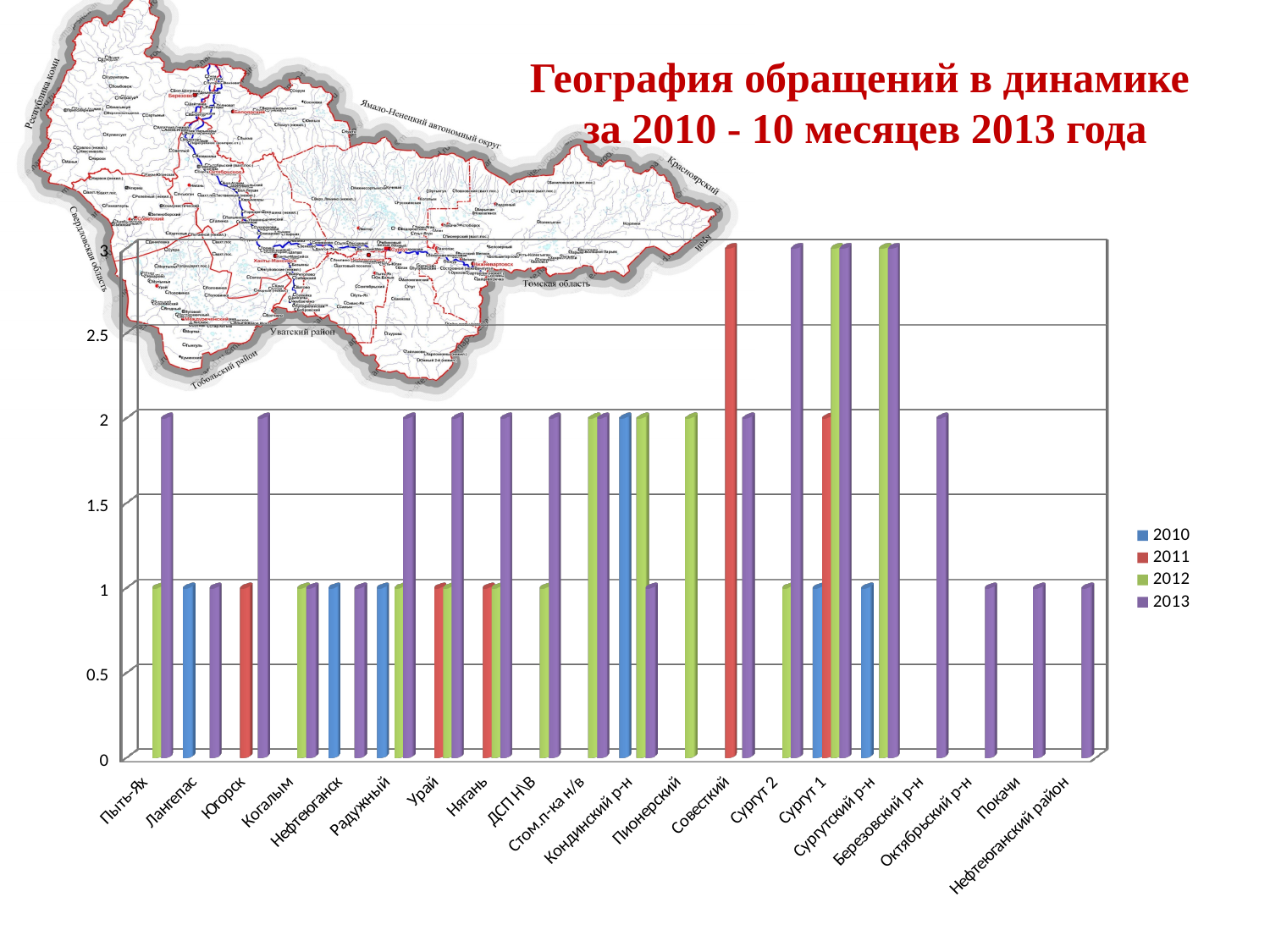
Which series is shown in purple in the legend? 2013 What is the value for Пионерский in 2012? 2 What kind of chart is shown on the slide? bar chart Which is larger for Советский: the 2011 value or the 2013 value? 2011 Is the 2013 value for Покачи greater or less than 2? less What is the title of the chart on the slide? География обращений в динамике за 2010 - 10 месяцев 2013 года What is the value for Советский in 2011? 3 How many categories are shown on the x axis of the chart? 20 What is the value for Березовский р-н in 2013? 2 What is the difference between the 2013 value for Сургут 2 and the 2012 value for Сургут 2? 2 What is the value for Сургут 2 in 2013? 3 How many series does the legend list? 4